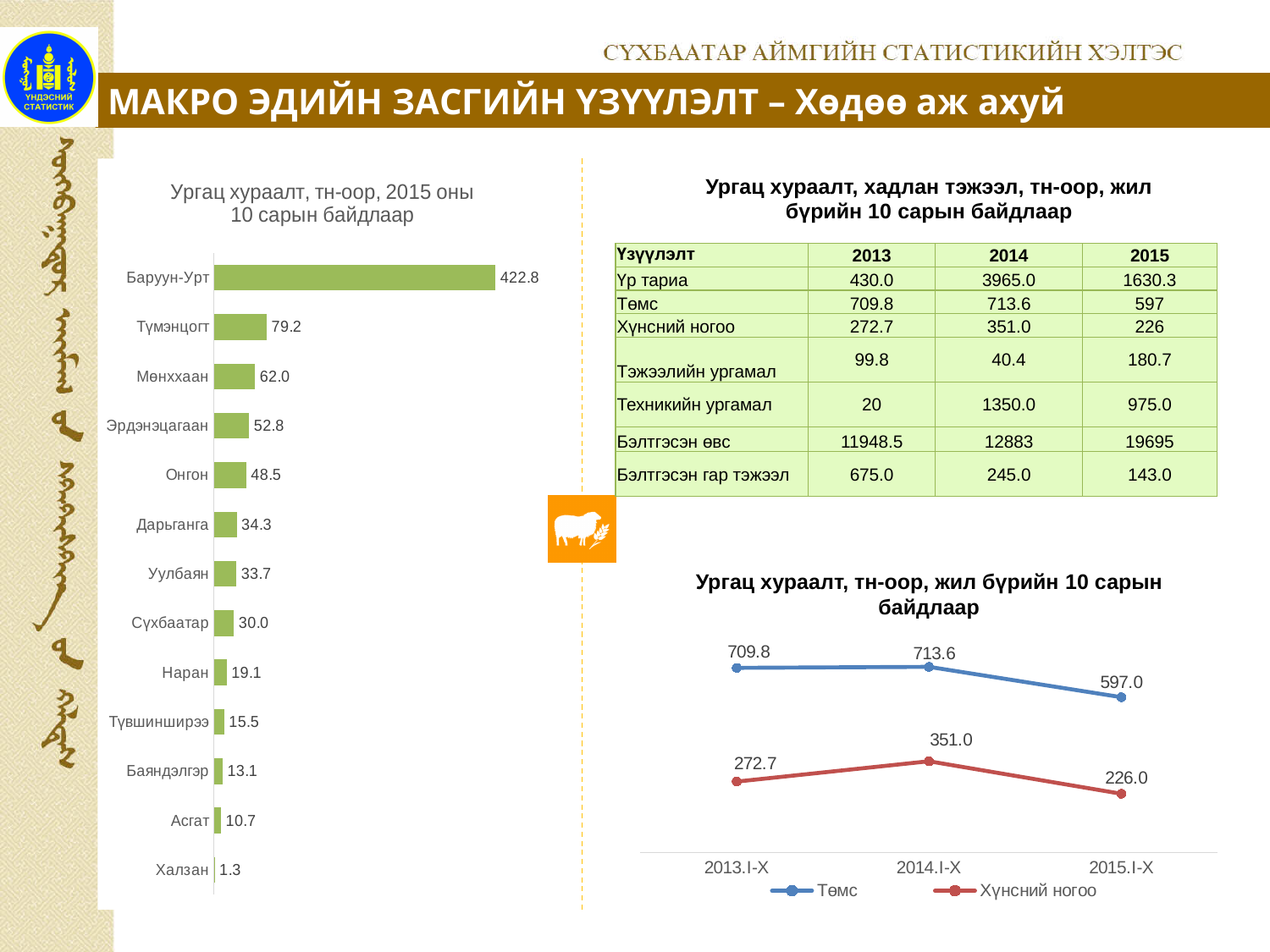
In the bar chart on the left, what is the value for Баруун-Урт? 422.8 In the bar chart on the left, what is the difference between the values for Түмэнцогт and Мөнххаан? 17.2 In the bar chart on the left, which category has the lowest value? Халзан In the bar chart on the left, which is larger, the value for Онгон or the value for Дарьганга? Онгон In the line chart at the bottom right, what is the value for Төмс in 2014.I-X? 713.6 In the line chart at the bottom right, what is the difference between the Төмс values for 2013.I-X and 2015.I-X? 112.8 What kind of chart is the chart on the left of the slide? Bar chart How many categories are shown in the bar chart on the left? 13 In the line chart at the bottom right, what is the value for Хүнсний ногоо in 2015.I-X? 226.0 In the line chart at the bottom right, does the Хүнсний ногоо series rise or fall from 2014.I-X to 2015.I-X? Fall In the bar chart on the left, which category has the highest value? Баруун-Урт How many series does the legend of the line chart at the bottom right list? 2